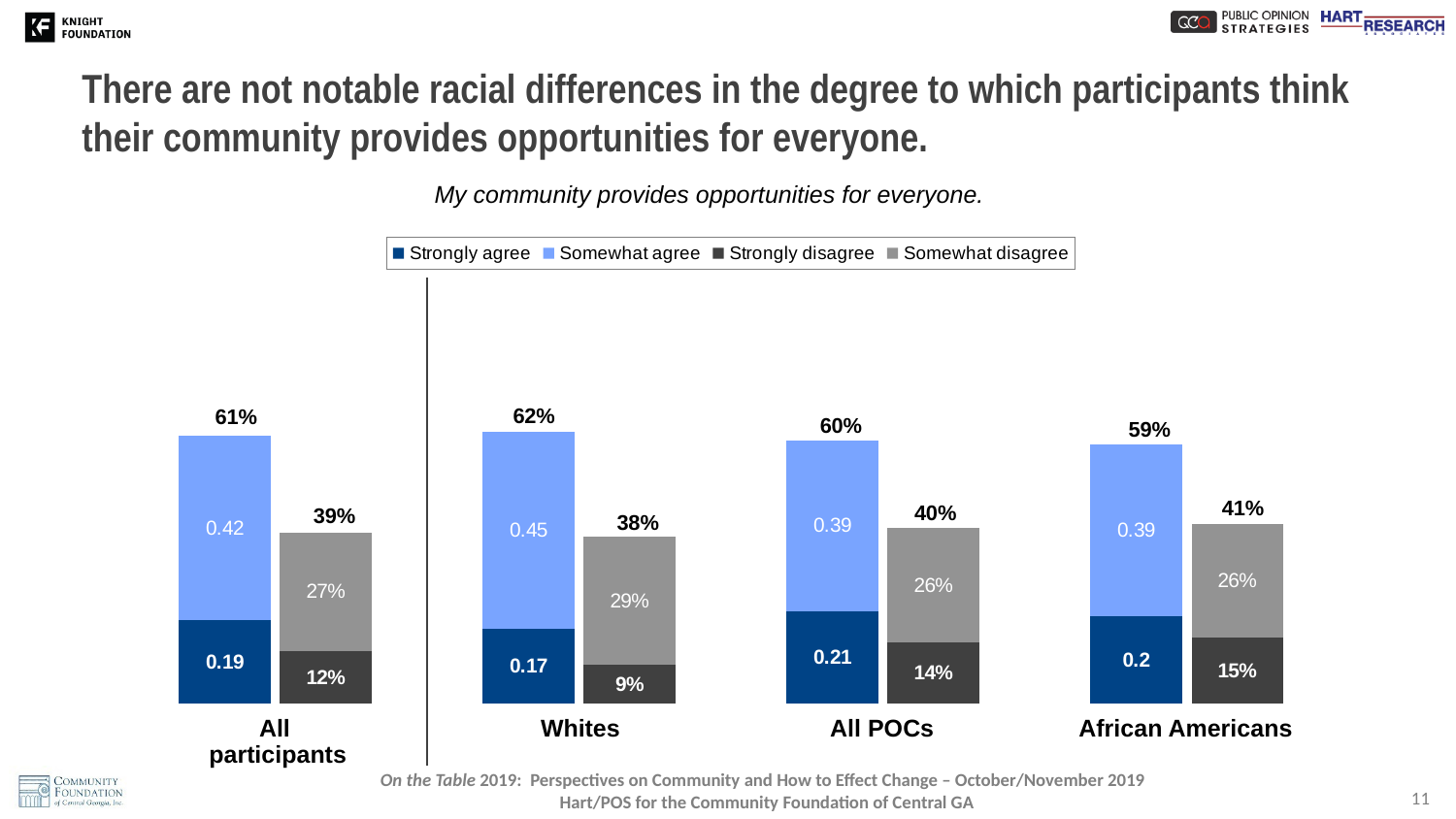
What is the Somewhat disagree value for Whites? 29% How many series does the legend list? 4 Which group has the highest total agree percentage? Whites What kind of chart is shown on the slide? Stacked bar chart What is the Somewhat agree value labeled on the bar for All participants? 0.42 Which group has the lowest Strongly disagree percentage? Whites What is the Strongly disagree value for All POCs? 14% What is the Strongly agree value labeled on the bar for African Americans? 0.2 Is the Strongly disagree value larger for All POCs or for Whites? All POCs What is the difference between the total agree and total disagree percentages for African Americans? 18% How many groups are shown along the x axis of the chart? 4 What is the total agree value (Strongly agree plus Somewhat agree) shown above the bar for Whites? 62%